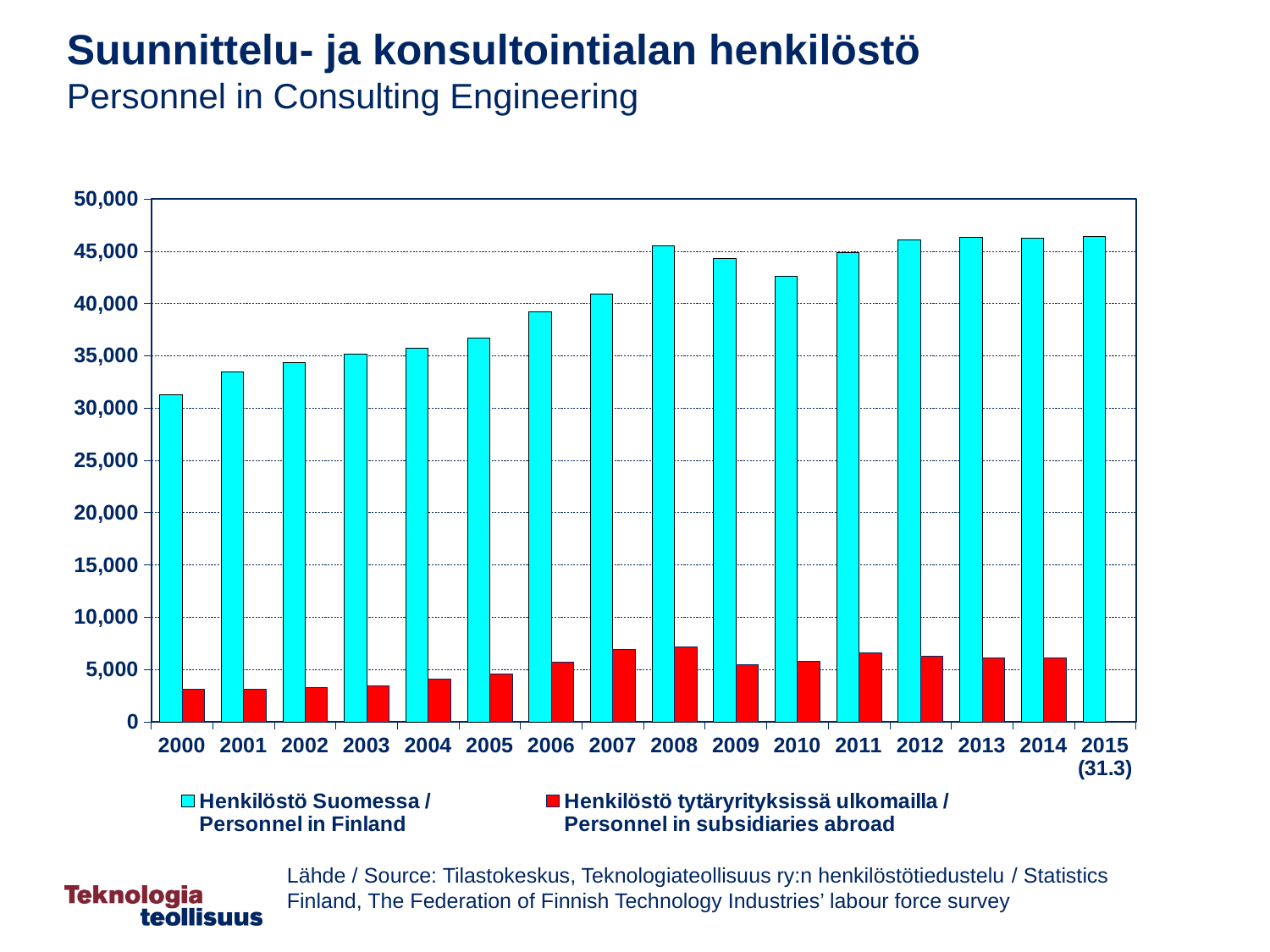
Is the value for Personnel in subsidiaries abroad in 2008 greater or less than 5,000? greater What kind of chart is shown on the slide? bar chart Which year has the lowest value for Personnel in Finland? 2000 Is the value for Personnel in Finland in 2010 greater or less than 40,000? greater How many series does the legend list? 2 Which is larger, Personnel in Finland in 2008 or in 2009? 2008 Does Personnel in Finland generally rise or fall from 2000 to 2015? rise Is the value for Personnel in Finland in 2006 greater or less than 40,000? less How many years are shown on the x axis? 16 What colour are the bars for Personnel in subsidiaries abroad? red